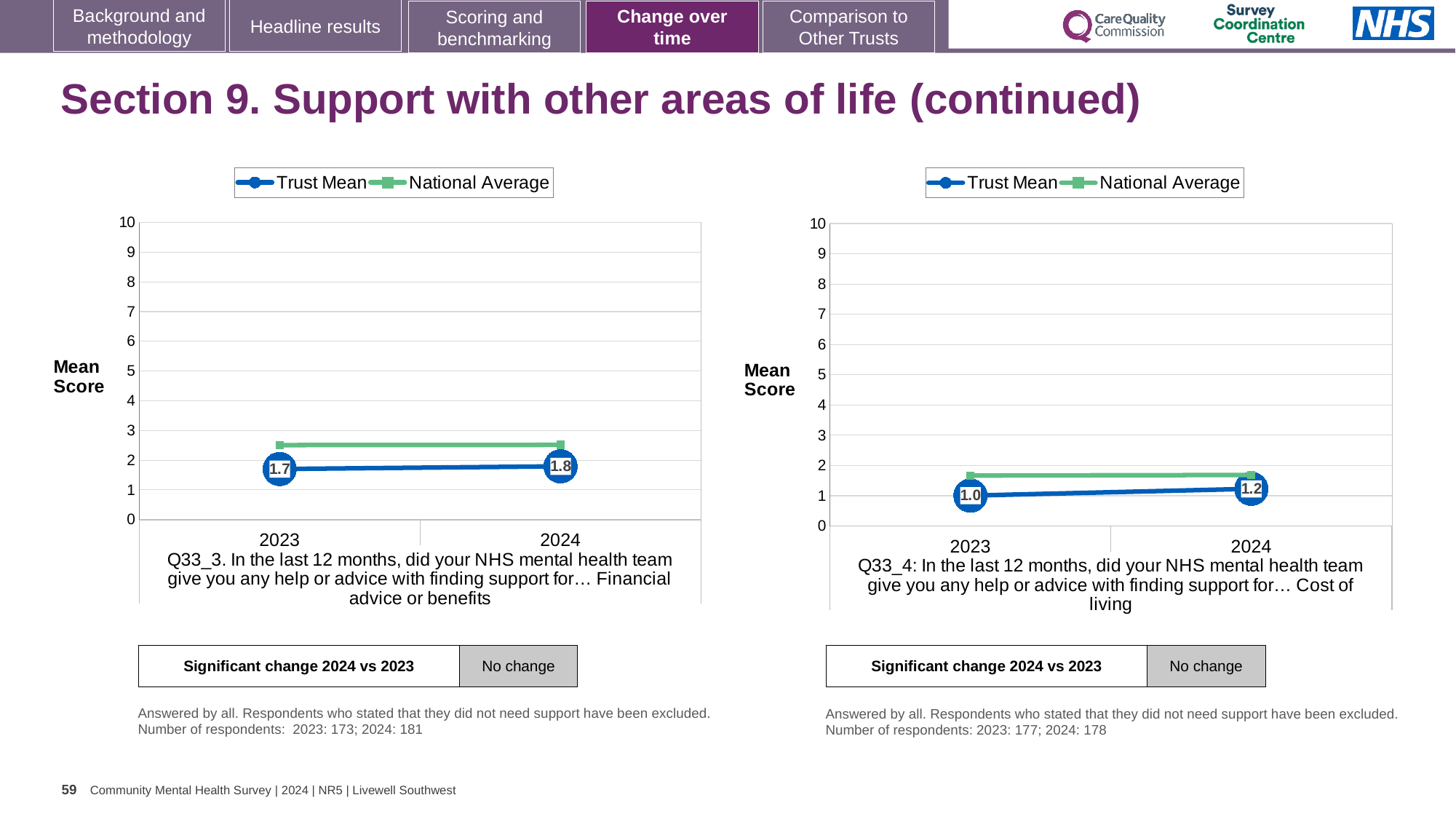
In the right chart (Q33_4, Cost of living), by how much did the Trust Mean change from 2023 to 2024? 0.2 How many years are plotted on the x axis of the left chart (Q33_3, Financial advice or benefits)? 2 In the left chart (Q33_3, Financial advice or benefits), is the National Average for 2024 greater or less than 2? greater In the left chart (Q33_3, Financial advice or benefits), does the Trust Mean rise or fall from 2023 to 2024? rise In the left chart (Q33_3, Financial advice or benefits), what is the Trust Mean score for 2023? 1.7 In the right chart (Q33_4, Cost of living), is the National Average for 2023 greater or less than 2? less In the right chart (Q33_4, Cost of living), what is the Trust Mean score for 2024? 1.2 What type of chart is the right chart (Q33_4, Cost of living)? line chart In the right chart (Q33_4, Cost of living), what is the Trust Mean score for 2023? 1.0 In the left chart (Q33_3, Financial advice or benefits), what is the Trust Mean score for 2024? 1.8 In the left chart (Q33_3, Financial advice or benefits), which series is higher in 2024, Trust Mean or National Average? National Average How many series does the legend of the right chart (Q33_4, Cost of living) list? 2